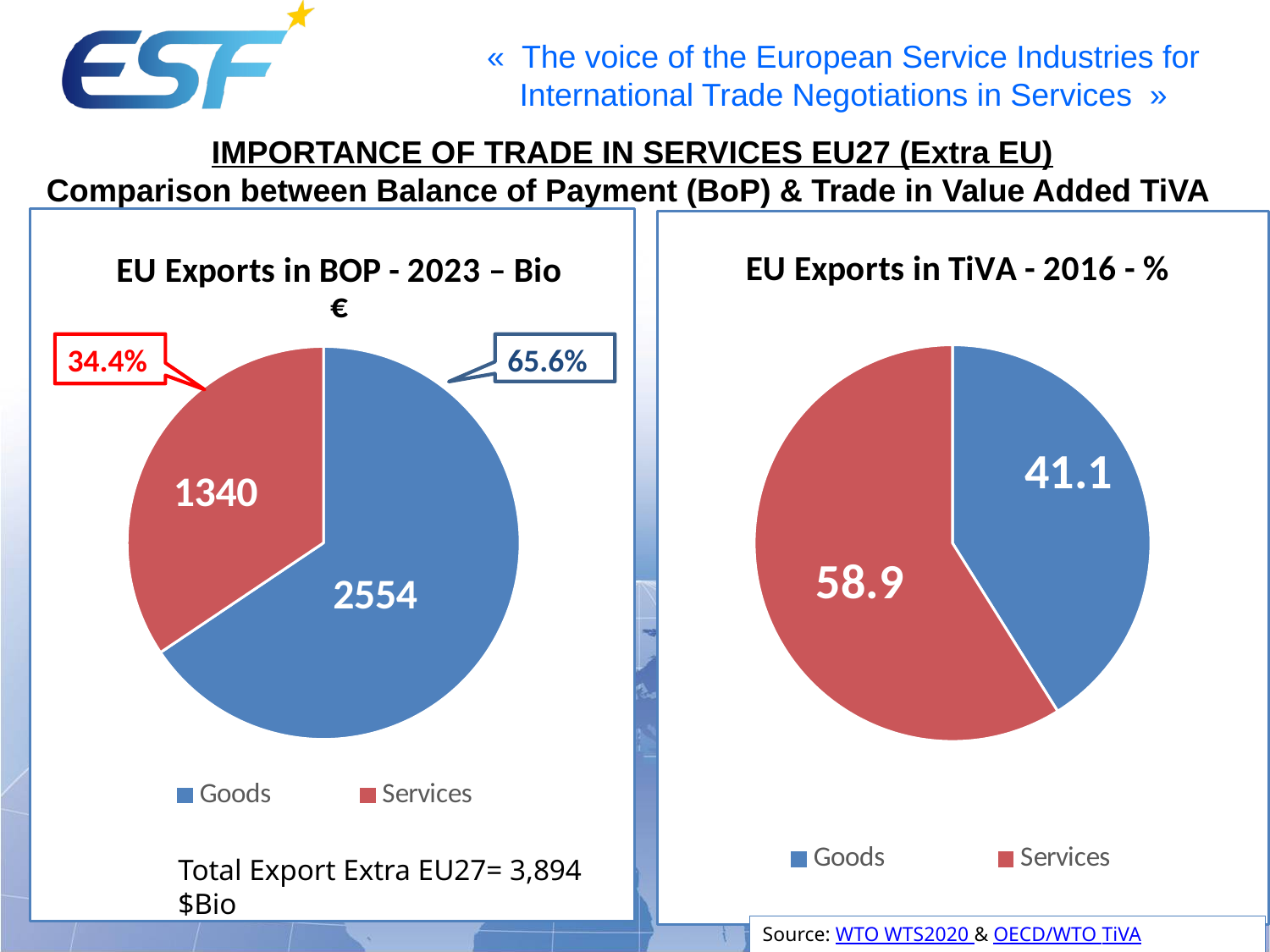
In the 'EU Exports in TiVA - 2016' chart, which category has the smaller slice? Goods In the 'EU Exports in BOP - 2023' chart, what is the value for Goods? 2554 In the 'EU Exports in BOP - 2023' chart, what is the difference between the Goods and Services values? 1214 In the 'EU Exports in TiVA - 2016' chart, what is the value for Services? 58.9 In the 'EU Exports in TiVA - 2016' chart, what is the value for Goods? 41.1 In the 'EU Exports in BOP - 2023' chart, what percentage share is shown for Services? 34.4% In the 'EU Exports in BOP - 2023' chart, what is the value for Services? 1340 In the 'EU Exports in TiVA - 2016' chart, is the value for Services larger or smaller than the value for Goods? larger What type of chart is used on the left side of the slide? Pie chart In the 'EU Exports in BOP - 2023' chart, what percentage share is shown for Goods? 65.6% In the 'EU Exports in BOP - 2023' chart, which category has the larger slice? Goods How many categories does the legend of the 'EU Exports in TiVA - 2016' chart list? 2